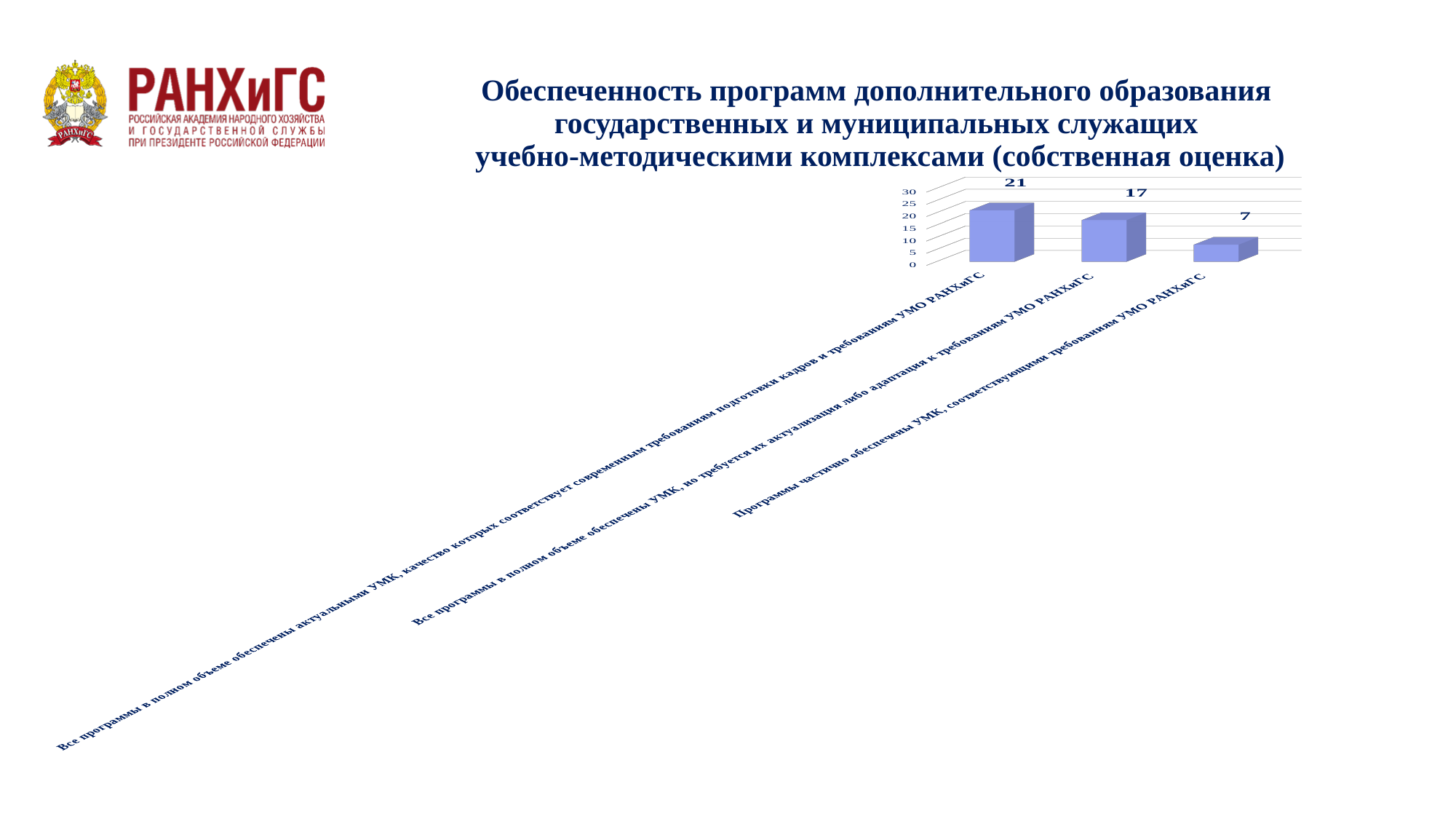
Which is larger: the value for programs fully provided with up-to-date УМК (first bar) or the value for programs fully provided with УМК that need updating (second bar)? The first bar (21) What value is shown for the category "Все программы в полном объеме обеспечены актуальными УМК, качество которых соответствует современным требованиям подготовки кадров и требованиям УМО РАНХиГС"? 21 Which category has the highest value? Все программы в полном объеме обеспечены актуальными УМК, качество которых соответствует современным требованиям подготовки кадров и требованиям УМО РАНХиГС Is the value for "Программы частично обеспечены УМК, соответствующими требованиям УМО РАНХиГС" greater or less than 10? less What is the difference between the values 21 and 17 shown for the first two categories? 4 How many categories are plotted in the chart? 3 Do the values rise or fall from left to right across the categories? Fall What value is shown for the category "Программы частично обеспечены УМК, соответствующими требованиям УМО РАНХиГС"? 7 What value is shown for the category "Все программы в полном объеме обеспечены УМК, но требуется их актуализация либо адаптация к требованиям УМО РАНХиГС"? 17 What is the difference between the highest value (21) and the lowest value (7)? 14 What kind of chart is shown on the slide? Bar chart Which category has the lowest value? Программы частично обеспечены УМК, соответствующими требованиям УМО РАНХиГС